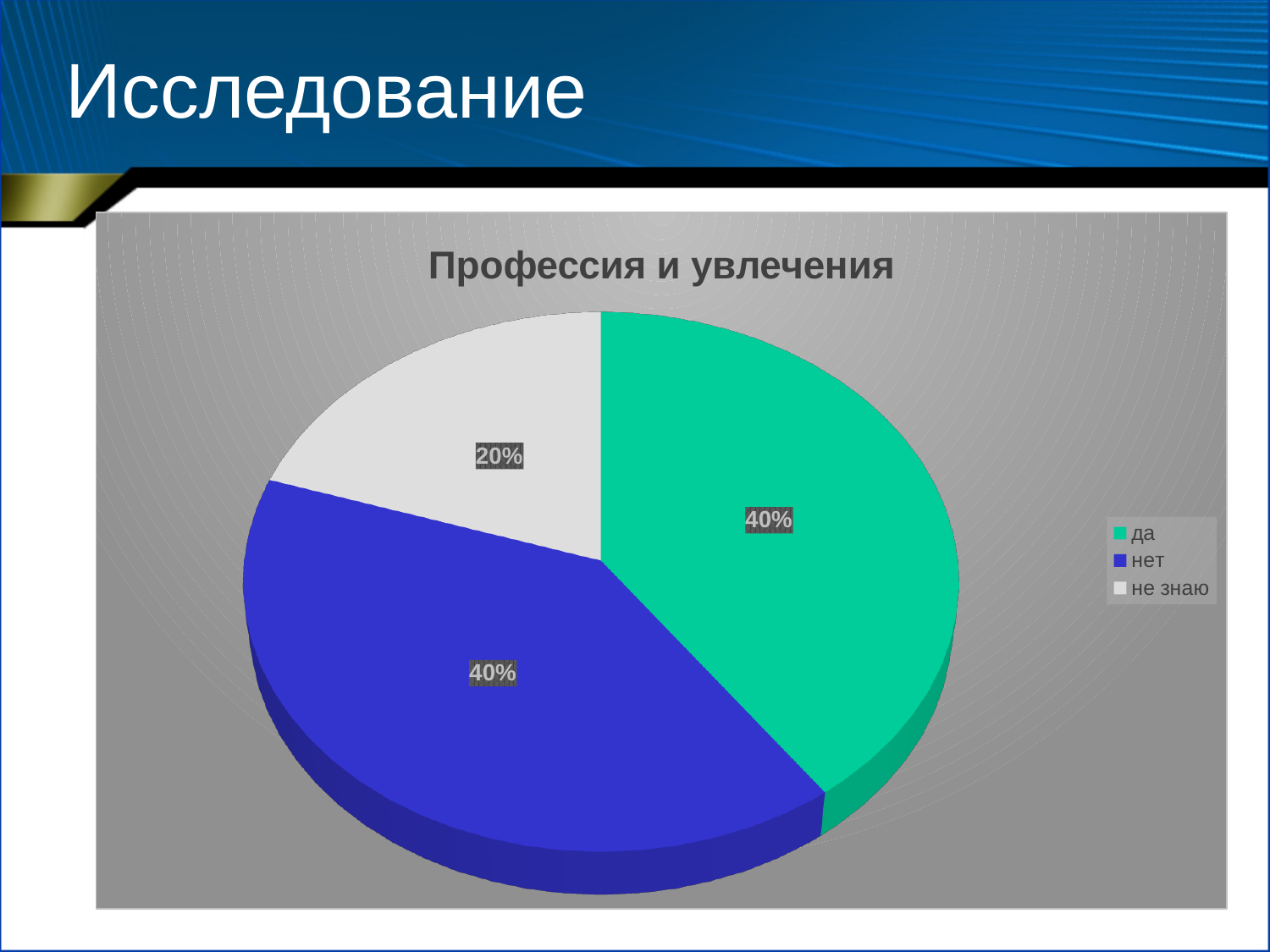
Is the value for "не знаю" greater or less than 30%? less What kind of chart is shown on the slide? pie chart Which is larger, the slice for "нет" or the slice for "не знаю"? нет What is the title of the chart? Профессия и увлечения How many slices does the pie chart have? 3 What is the difference in percentage points between the "да" slice and the "не знаю" slice? 20 What is the value shown for "нет"? 40% Which category is shown in the green colour in the legend? да What is the value shown for "не знаю"? 20% Which category has the smallest slice of the pie? не знаю What share of the pie does the "да" slice represent? 40%